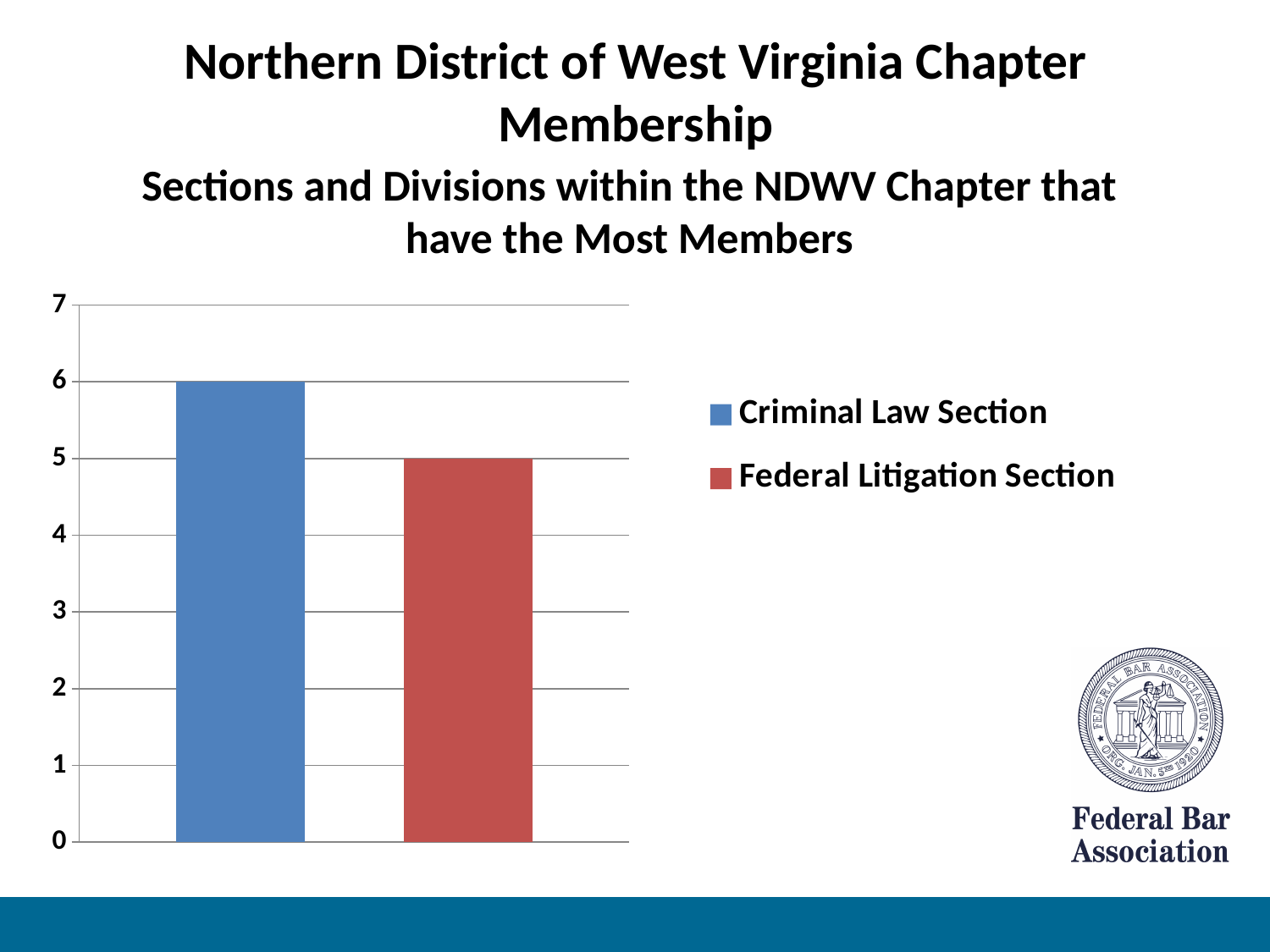
How many series does the legend list? 2 What is the value for the Federal Litigation Section? 5 Is the value for the Federal Litigation Section greater or less than 4? greater What is the difference between the Criminal Law Section and the Federal Litigation Section values? 1 Which section has the highest value? Criminal Law Section What colour is the bar for the Federal Litigation Section? red Which is larger, the Criminal Law Section or the Federal Litigation Section? Criminal Law Section How many bars are plotted in the chart? 2 Which section has the lowest value? Federal Litigation Section What is the value for the Criminal Law Section? 6 What kind of chart is shown on the slide? bar chart What is the highest value shown on the vertical axis? 7